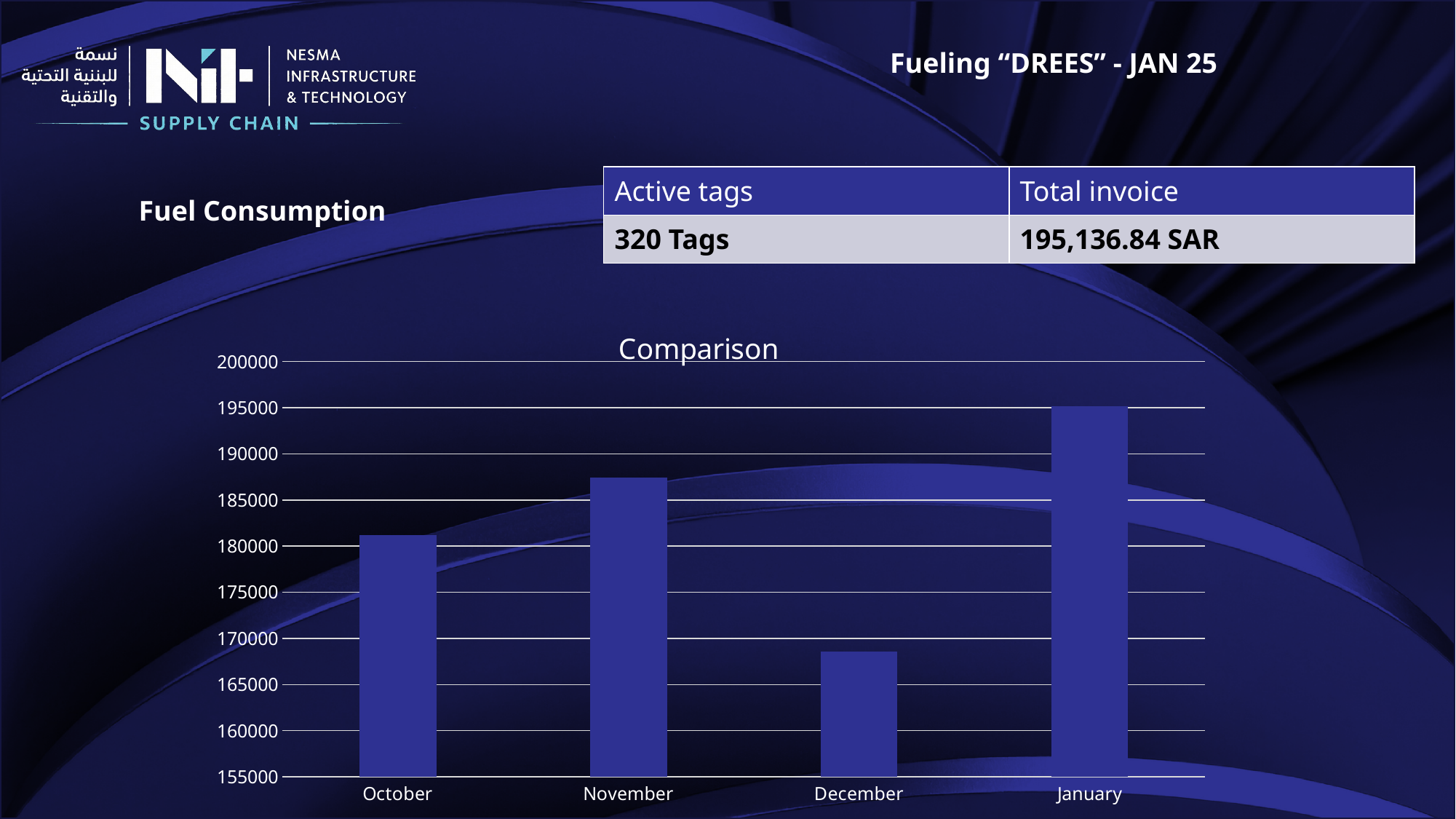
Which is larger, the value for October or the value for November? November What is the title of the chart? Comparison What type of chart is shown on the slide? bar chart Which is larger, the value for December or the value for January? January Which month has the highest value in the chart? January Which month has the lowest value in the chart? December Is the value for December greater or less than 170000? less Is the value for October greater or less than 180000? greater How many months are plotted in the chart? 4 Is the value for November greater or less than 185000? greater Does the value rise or fall from November to December? fall